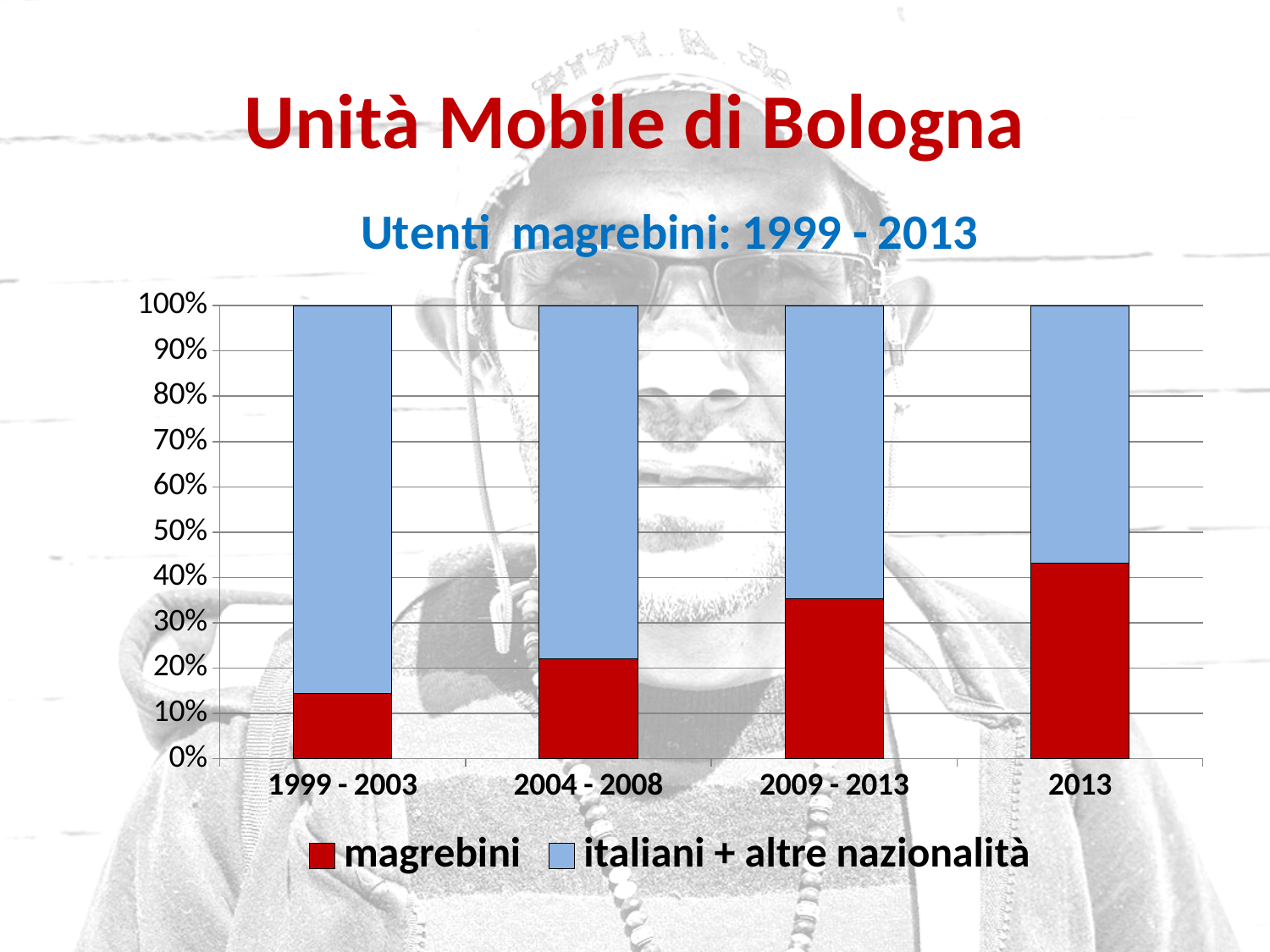
Which category has the highest share of magrebini? 2013 Is the share of magrebini for 2013 greater or less than 40%? greater How many series does the legend list? 2 Which is larger, the share of magrebini in 2004 - 2008 or in 2009 - 2013? 2009 - 2013 Is the share of magrebini for 1999 - 2003 greater or less than 20%? less What is the title of the chart? Utenti magrebini: 1999 - 2013 What kind of chart is shown on the slide? stacked bar chart Which category has the lowest share of magrebini? 1999 - 2003 How many categories are shown on the x axis? 4 Is the share of magrebini for 2009 - 2013 greater or less than 30%? greater Does the share of magrebini rise or fall across the categories from 1999 - 2003 to 2013? rise